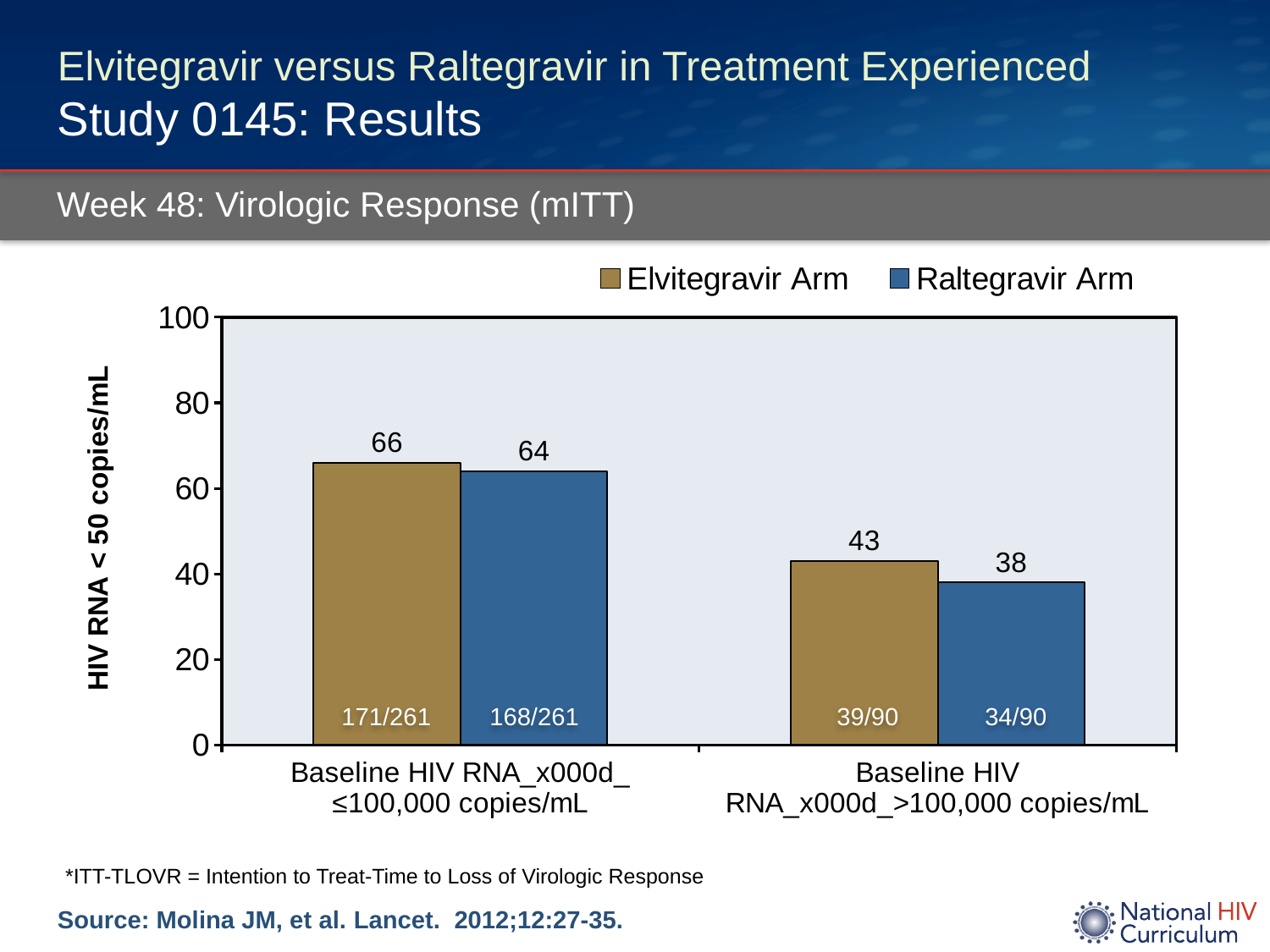
What is the value for the Raltegravir Arm in the Baseline HIV RNA >100,000 copies/mL category? 38 What is the label of the y axis? HIV RNA < 50 copies/mL How many series does the legend list? 2 What kind of chart is shown on the slide? Bar chart What is the value for the Elvitegravir Arm in the Baseline HIV RNA ≤100,000 copies/mL category? 66 In the Baseline HIV RNA ≤100,000 copies/mL category, which arm has the larger value? Elvitegravir Arm What is the difference between the Elvitegravir Arm and Raltegravir Arm values in the Baseline HIV RNA >100,000 copies/mL category? 5 Which bar has the lowest value on the chart? Raltegravir Arm, Baseline HIV RNA >100,000 copies/mL How many categories are shown on the x axis? 2 What is the value for the Raltegravir Arm in the Baseline HIV RNA ≤100,000 copies/mL category? 64 Which bar has the highest value on the chart? Elvitegravir Arm, Baseline HIV RNA ≤100,000 copies/mL What fraction is printed inside the Elvitegravir Arm bar for the Baseline HIV RNA >100,000 copies/mL category? 39/90